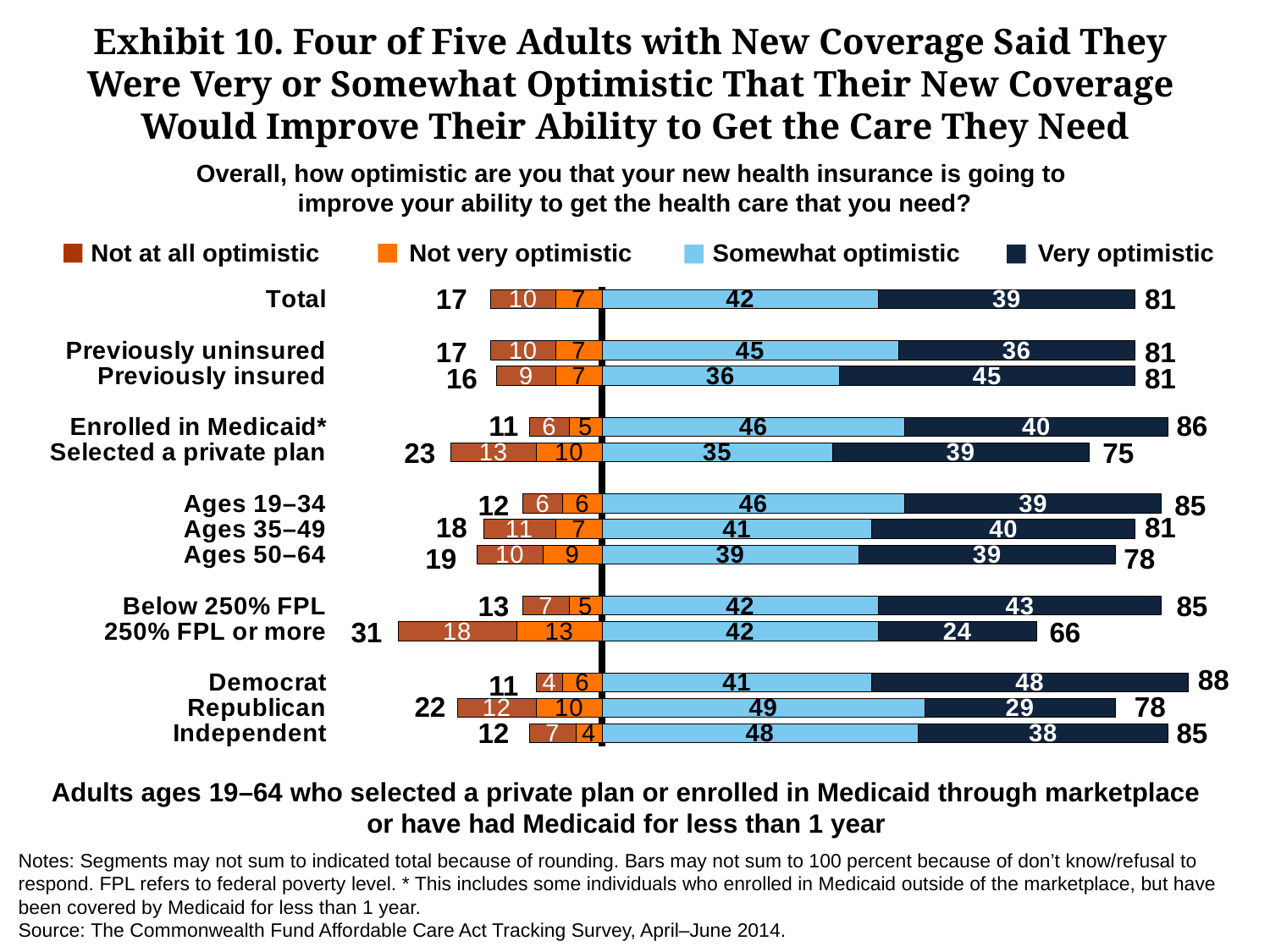
How much higher is the very optimistic share for Democrats than for Republicans? 19 Which group has the highest combined very or somewhat optimistic total? Democrat What percentage of Republicans said they were somewhat optimistic? 49 How many response categories does the legend list? 4 Which group has a larger somewhat optimistic share, previously uninsured or previously insured? Previously uninsured What percentage of adults at 250% FPL or more said they were not at all optimistic? 18 How many groups (bars) are shown in the chart? 13 What is the combined not at all optimistic and not very optimistic total for those who selected a private plan? 23 Which group has the lowest combined very or somewhat optimistic total? 250% FPL or more What percentage of Democrats said they were very optimistic? 48 What kind of chart is shown on the slide? Stacked bar chart What is the combined very or somewhat optimistic total for those enrolled in Medicaid? 86